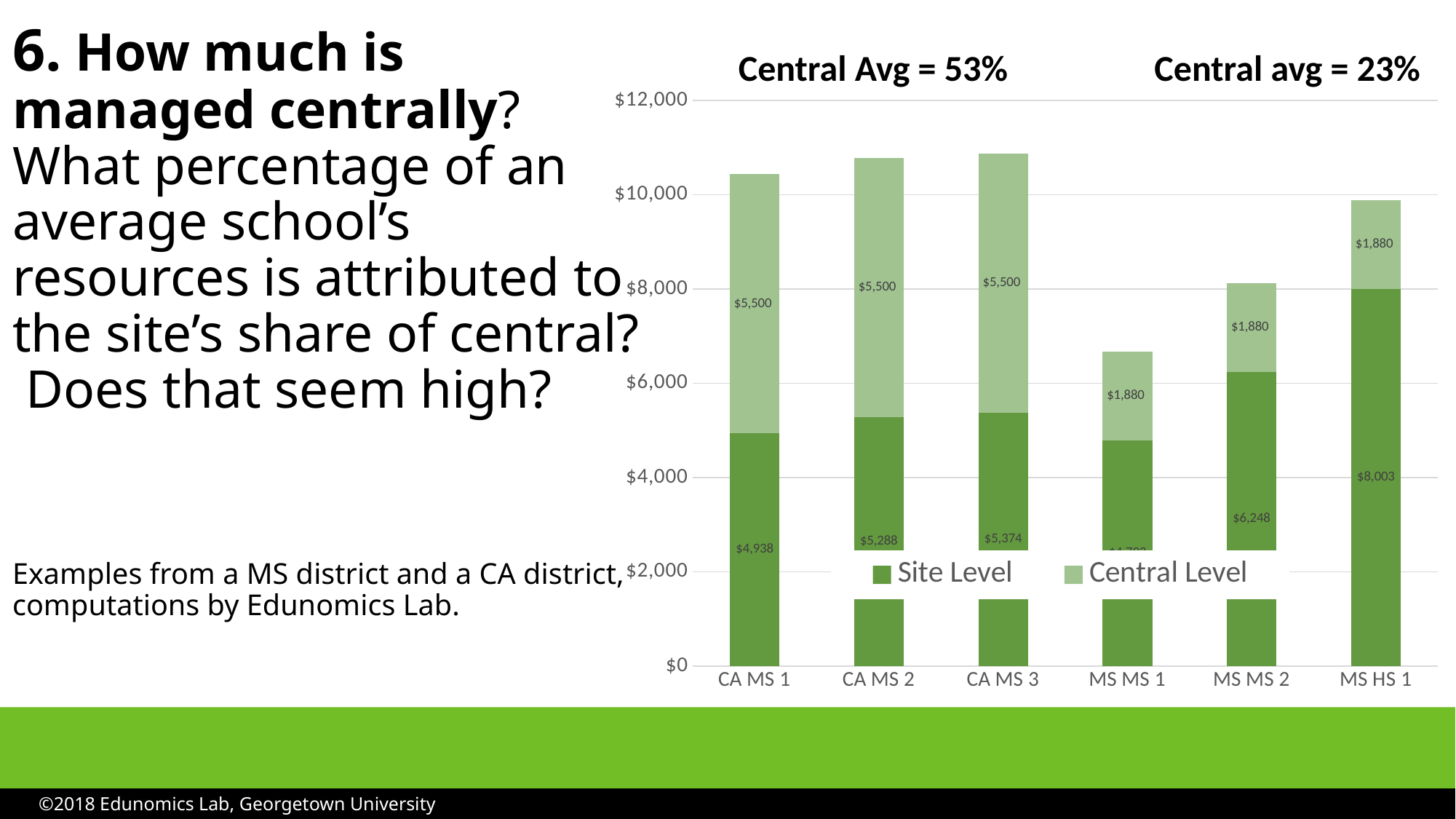
What kind of chart is shown on the slide? bar chart What is the Site Level value for CA MS 1? $4,938 How many schools (categories) are shown on the x axis of the chart? 6 What is the Central Level value for MS HS 1? $1,880 What is the difference between the Site Level values for MS HS 1 and MS MS 2? $1,755 What is the total of the stacked bar for CA MS 1 (Site Level plus Central Level)? $10,438 How many series does the chart's legend list? 2 Which is larger, the Central Level value for CA MS 3 or for MS MS 1? CA MS 3 Is the total stacked bar for MS MS 1 greater or less than $6,000? greater What is the Central Level value for CA MS 2? $5,500 Which school has the lowest total stacked bar? MS MS 1 Which school has the highest Site Level value? MS HS 1